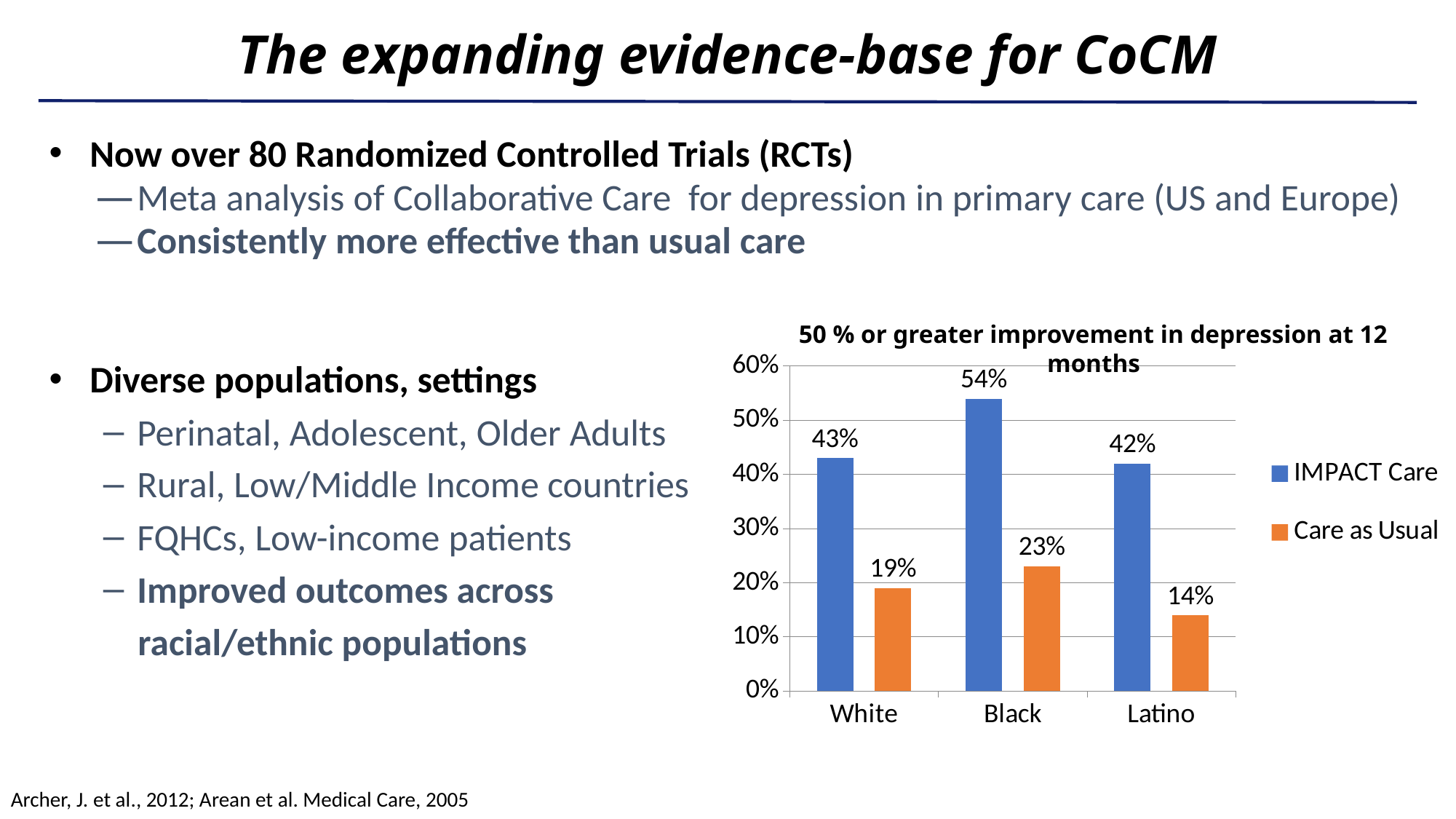
What is the title of the chart? 50 % or greater improvement in depression at 12 months Which is larger for Black: IMPACT Care or Care as Usual? IMPACT Care How many categories are shown on the x axis? 3 What is the Care as Usual value for Latino? 14% How many series does the legend list? 2 Which category has the highest IMPACT Care value? Black What is the IMPACT Care value for White? 43% What is the IMPACT Care value for Black? 54% Which category has the lowest Care as Usual value? Latino Is the Care as Usual value for Black greater or less than 20%? greater What is the difference between the IMPACT Care and Care as Usual values for White? 24% What kind of chart is shown? bar chart